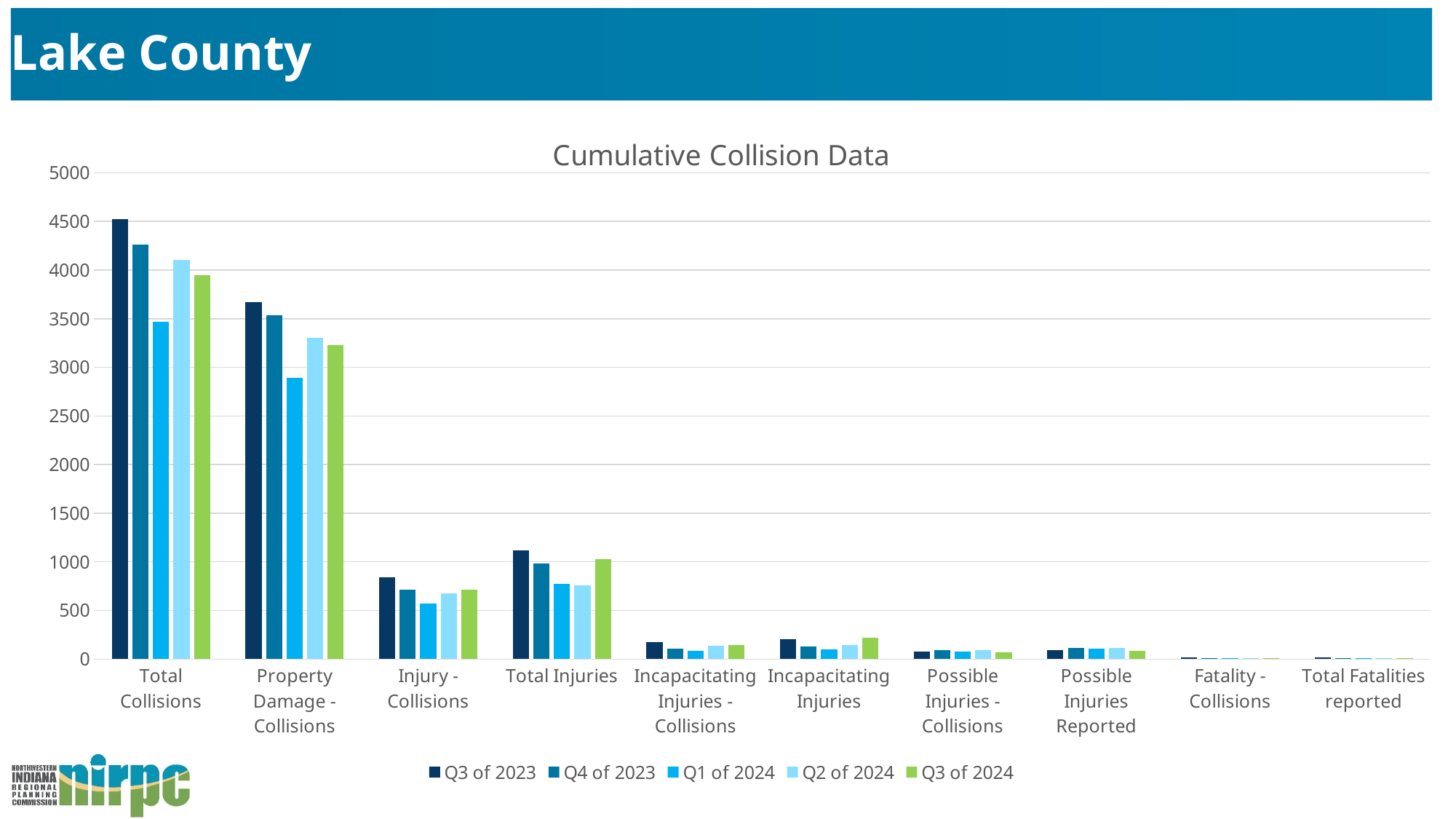
Which category has the highest bar for Q3 of 2023? Total Collisions How many categories are shown along the x axis? 10 For Total Collisions, which is larger: Q3 of 2023 or Q3 of 2024? Q3 of 2023 Is the value for Total Collisions in Q1 of 2024 greater or less than 4000? less How many series does the legend list? 5 What is the title of the chart? Cumulative Collision Data What kind of chart is shown on the slide? bar chart Is the value for Total Injuries in Q3 of 2023 greater or less than 1000? greater For Injury - Collisions, which is larger: Q3 of 2023 or Q1 of 2024? Q3 of 2023 Within the Total Collisions category, which series has the lowest bar? Q1 of 2024 Is the value for Property Damage - Collisions in Q1 of 2024 greater or less than 3000? less